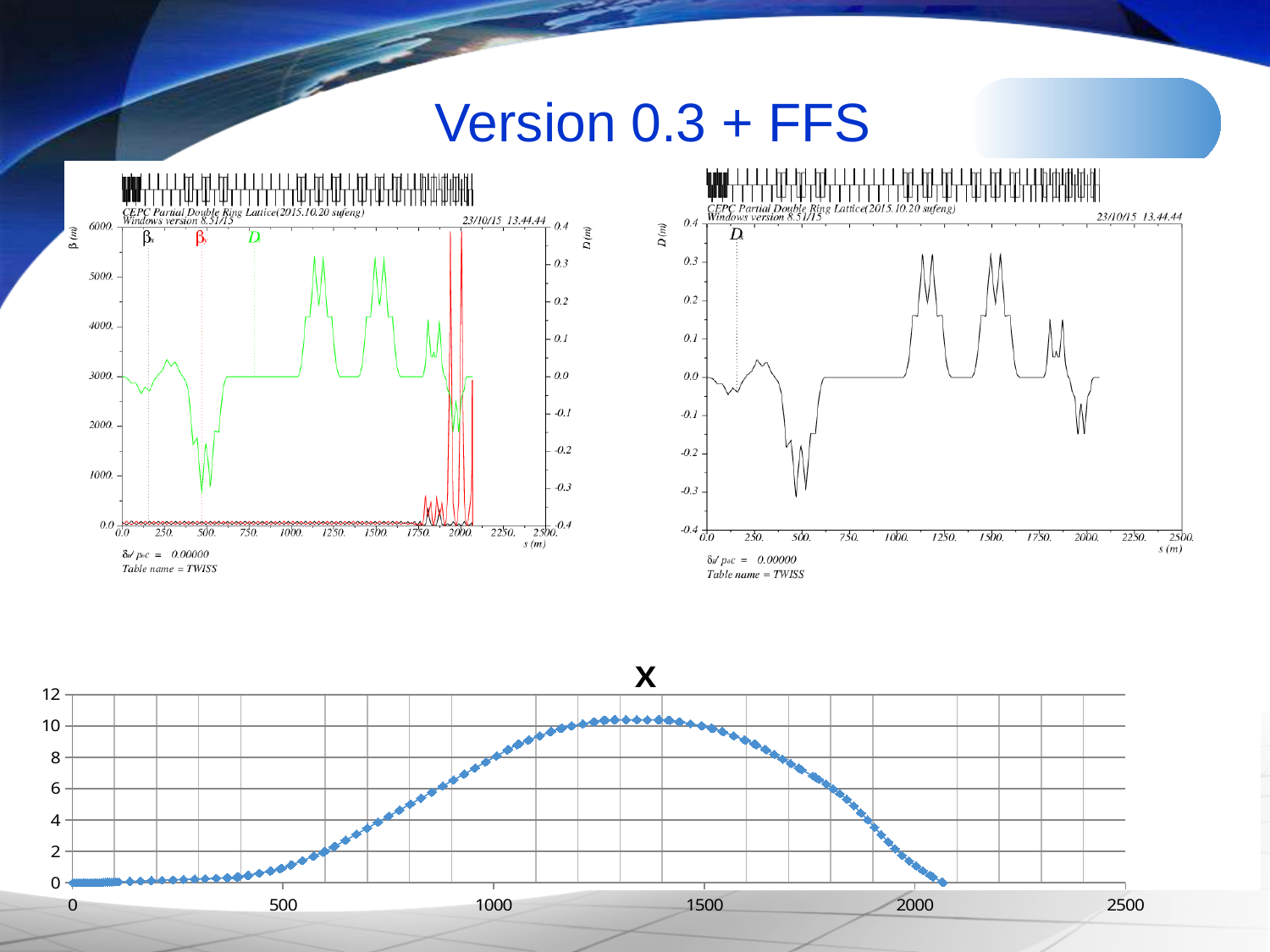
In the bottom chart titled "x", is the peak value greater or less than 10? greater In the bottom chart titled "x", is the value at x = 1500 greater or less than 8? greater How many series does the legend of the top-right chart list? 1 In the top-right chart, is the maximum value of Dx greater or less than 0.3? greater In the bottom chart titled "x", do the values rise or fall as x goes from 500 to 1000? rise How many series does the legend of the top-left chart list? 3 In the bottom chart titled "x", which is larger: the value at x = 1000 or the value at x = 2000? the value at x = 1000 In the top-right chart, what is the value of Dx at s = 1000 m? 0.0 What is the title of the bottom chart? x In the bottom chart titled "x", do the values rise or fall as x goes from 1500 to 2000? fall